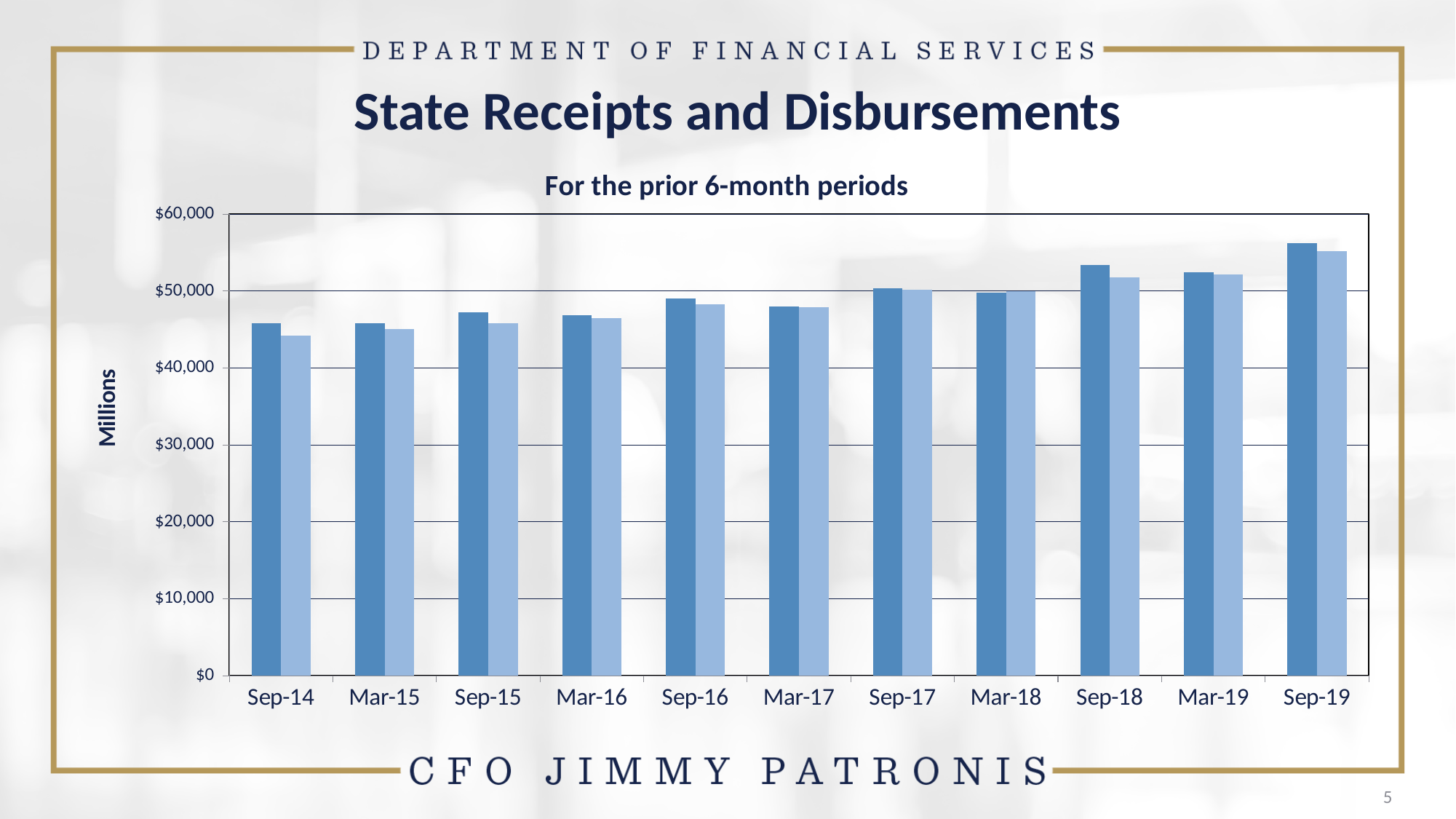
Which is larger, the dark blue bar for Sep-14 or the dark blue bar for Sep-19? Sep-19 Is the light blue bar for Sep-18 greater or less than $50,000? greater How many bars are plotted for each period on the chart? 2 How many time periods are shown on the x axis of the chart? 11 Is the dark blue bar for Sep-14 greater or less than $50,000? less Is the dark blue bar for Mar-17 greater or less than $50,000? less Overall, do the bar values rise or fall from Sep-14 to Sep-19? rise What is the label on the vertical axis of the chart? Millions What kind of chart is shown on the slide? bar chart Which period has the tallest dark blue bar? Sep-19 What is the title printed above the chart? For the prior 6-month periods